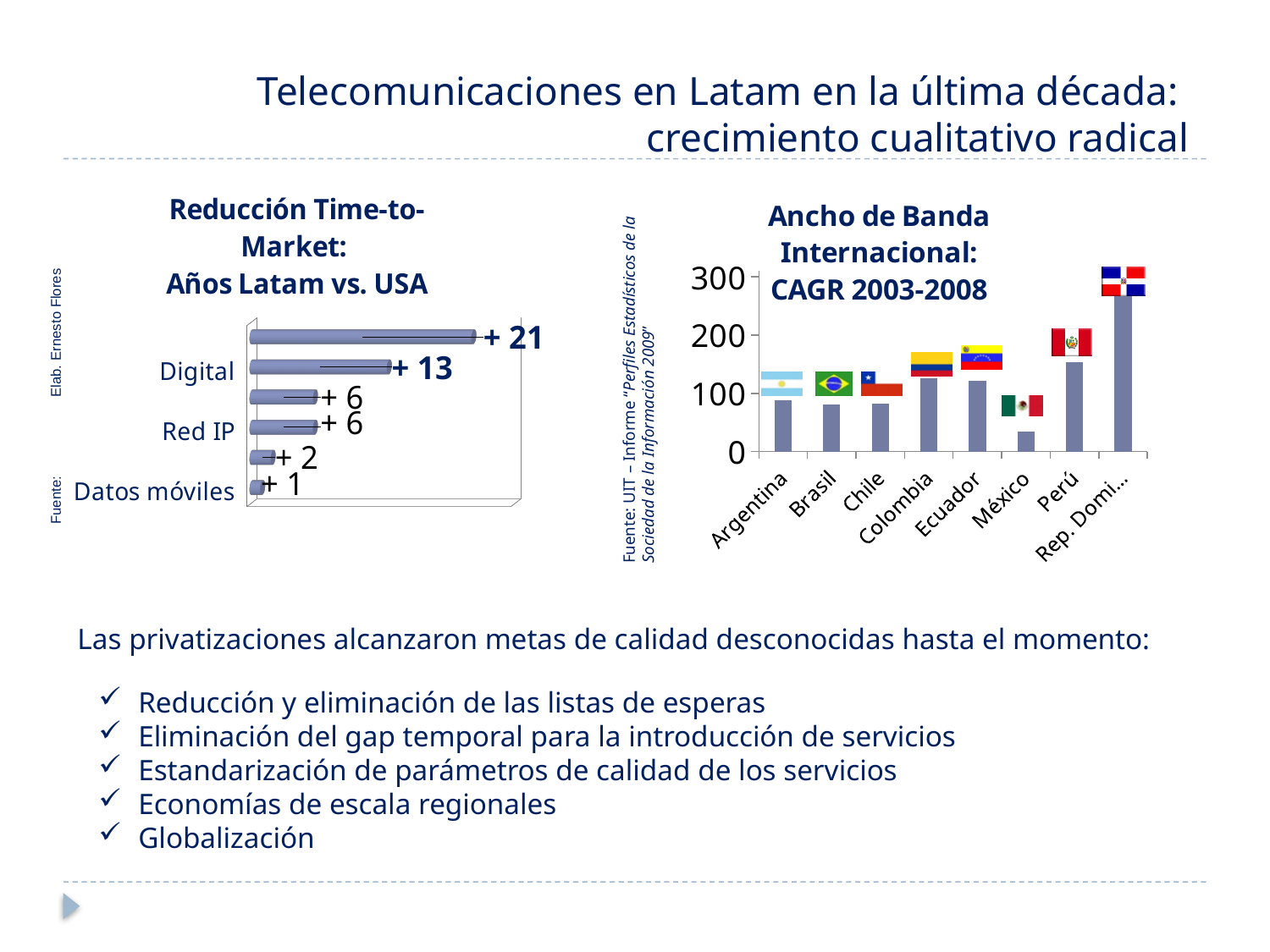
In the 'Reducción Time-to-Market' chart, what is the largest value shown on any bar? + 21 In the 'Reducción Time-to-Market' chart, what is the value for Red IP? + 6 In the 'Ancho de Banda Internacional' chart, is the value for Perú greater or less than 100? greater In the 'Ancho de Banda Internacional' chart, which country has the lowest value? México In the 'Reducción Time-to-Market' chart, what is the value for Datos móviles? + 1 In the 'Reducción Time-to-Market' chart, what is the difference between the values for Digital and Datos móviles? 12 In the 'Reducción Time-to-Market' chart, what is the value for Digital? + 13 In the 'Reducción Time-to-Market' chart, which labelled category has the lowest value? Datos móviles In the 'Ancho de Banda Internacional' chart, which is larger, the value for Colombia or the value for Argentina? Colombia What kind of chart is the 'Ancho de Banda Internacional: CAGR 2003-2008' chart? Bar chart How many countries are shown in the 'Ancho de Banda Internacional' chart? 8 How many bars are plotted in the 'Reducción Time-to-Market' chart? 6